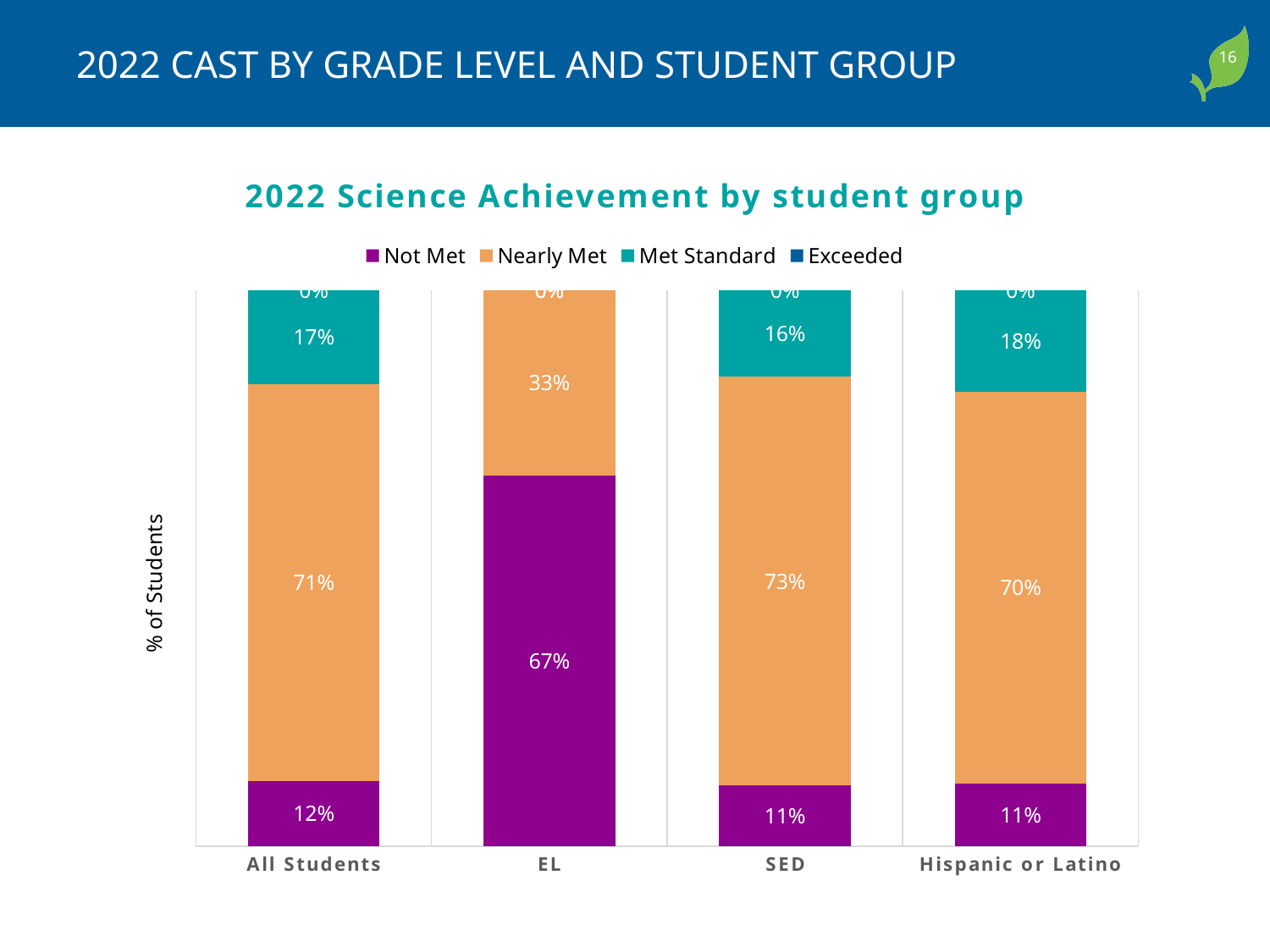
How many percentage points higher is the Not Met value for EL than for All Students? 55% What is the label on the vertical axis of the chart? % of Students What is the Nearly Met percentage for SED students? 73% How many series does the legend list? 4 Which student group has the highest Not Met percentage? EL How many student groups are shown on the x axis? 4 What percentage of Hispanic or Latino students Met Standard? 18% What type of chart is shown on the slide? Stacked bar chart Which has a larger Met Standard percentage, SED or All Students? All Students Which student group has the lowest Nearly Met percentage? EL What percentage of EL students are in the Not Met category? 67% What is the Not Met percentage for All Students? 12%